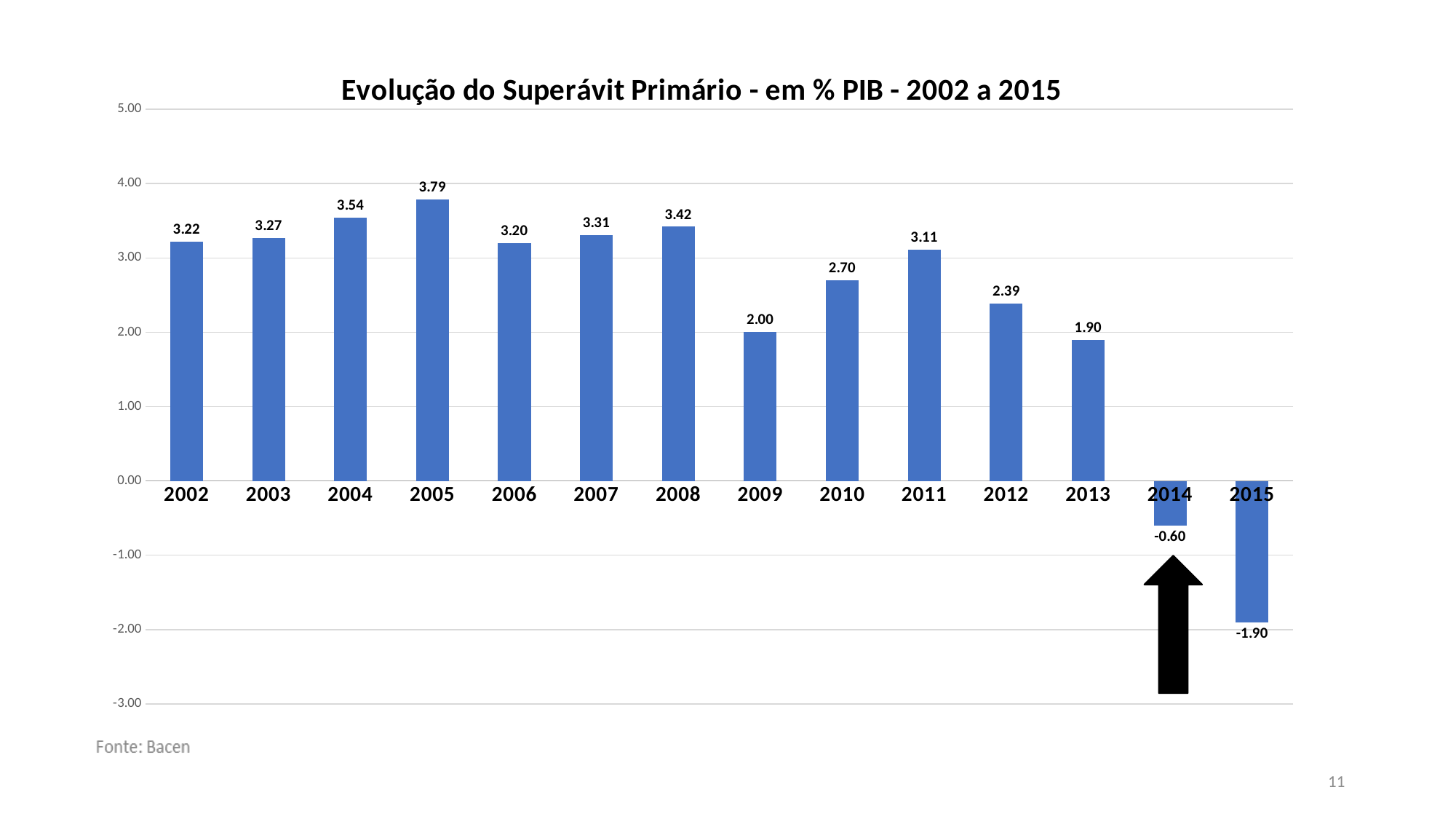
How many years are shown on the x axis? 14 Do the values rise or fall from 2008 to 2015? fall What is the value for 2009? 2.00 Which year has the lowest value? 2015 What is the difference between the values for 2004 and 2013? 1.64 What kind of chart is this? bar chart What is the value for 2005? 3.79 What is the value for 2014? -0.60 Which is larger, the value for 2008 or the value for 2011? 2008 What is the title of the chart? Evolução do Superávit Primário - em % PIB - 2002 a 2015 Which year has the highest value? 2005 Is the value for 2010 greater or less than 3.00? less